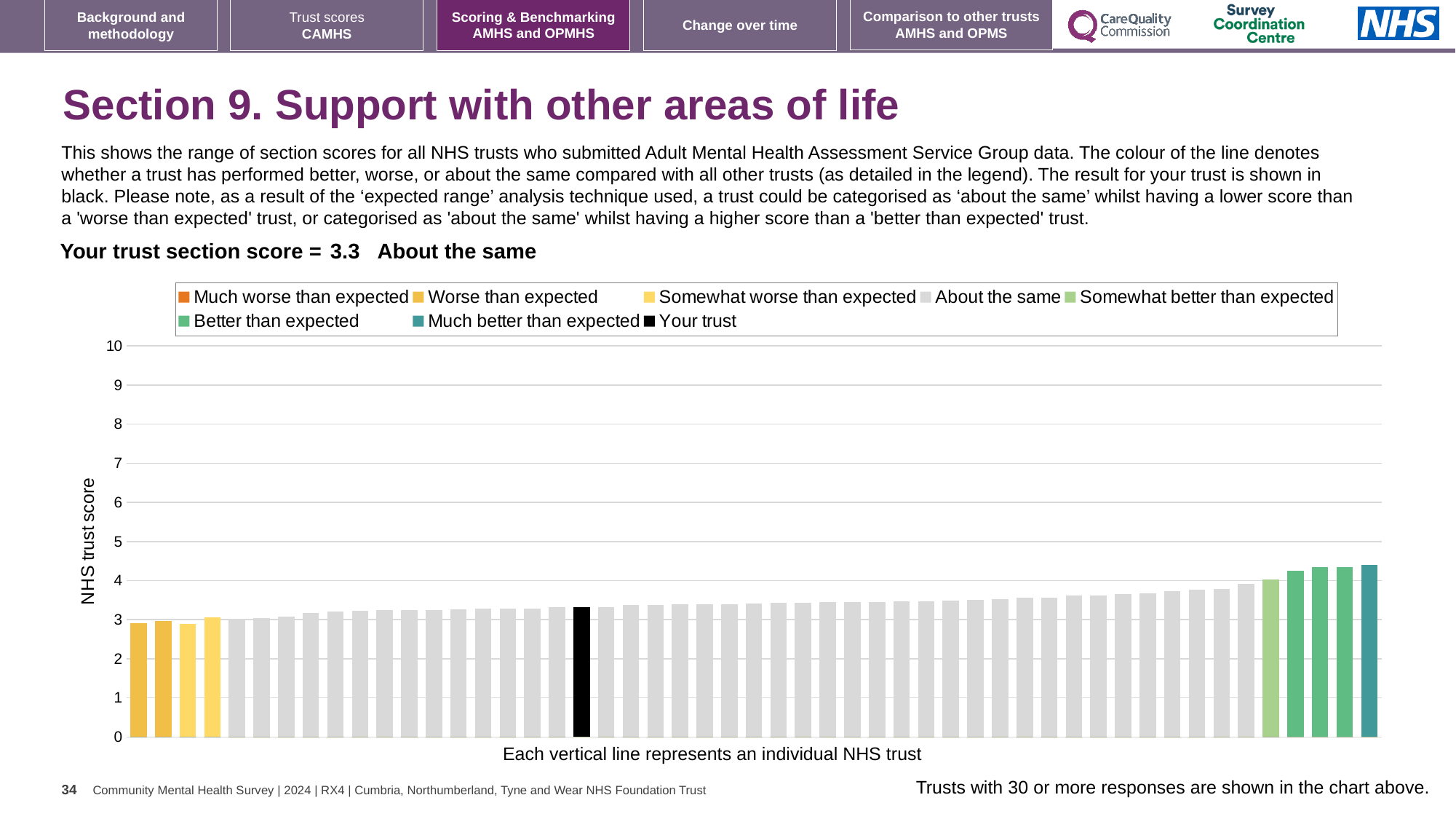
What is the section score for your trust? 3.3 How many bars are coloured as 'Much better than expected'? 1 Which legend category does the tallest bar belong to? Much better than expected How many bars are coloured as 'Better than expected'? 3 What kind of chart is shown on the slide? bar chart Do the bar values rise or fall from left to right along the x axis? rise What colour is the bar representing your trust? black Is the tallest bar in the chart greater or less than 5? less Is the value for your trust greater or less than 3? greater How many entries does the legend list? 8 Is the tallest bar in the chart greater or less than 4? greater What is the label on the vertical axis? NHS trust score